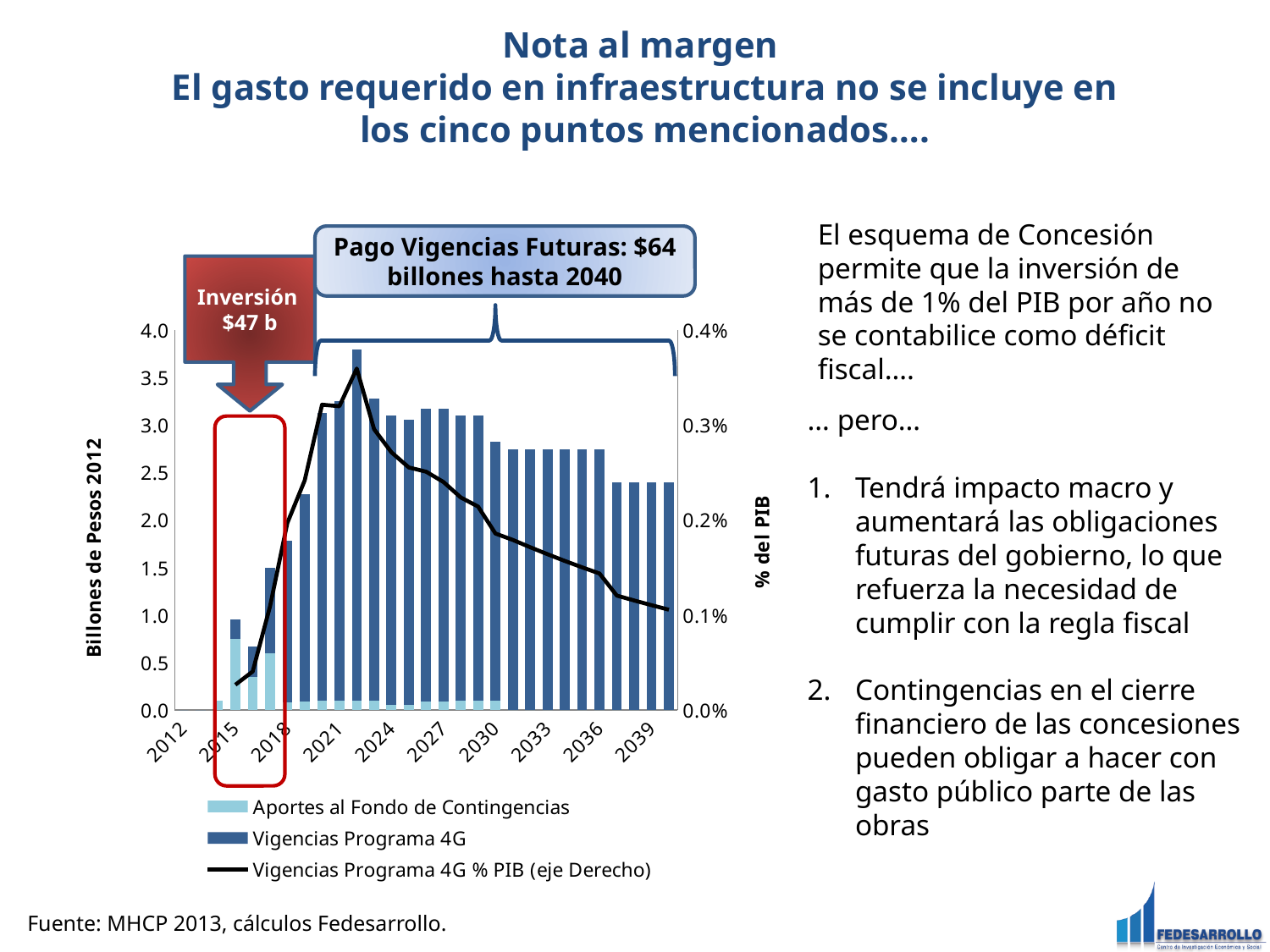
Does the 'Vigencias Programa 4G % PIB' line rise or fall between 2022 and 2040? Fall What type of chart is shown on the slide? A combination chart of stacked bars and a line Which year has a taller bar, 2022 or 2040? 2022 Which year has the tallest bar? 2022 In which year does the line 'Vigencias Programa 4G % PIB (eje Derecho)' reach its peak? 2022 Is the total bar value for 2033 greater or less than 3.0? less What is the title of the left vertical axis? Billones de Pesos 2012 How many series does the legend list? 3 Is the 'Vigencias Programa 4G % PIB' value for 2022 greater or less than 0.3%? greater Is the total bar value for 2022 greater or less than 3.5 billones de pesos? greater According to the callout above the chart, what is the total 'Pago Vigencias Futuras' until 2040? $64 billones